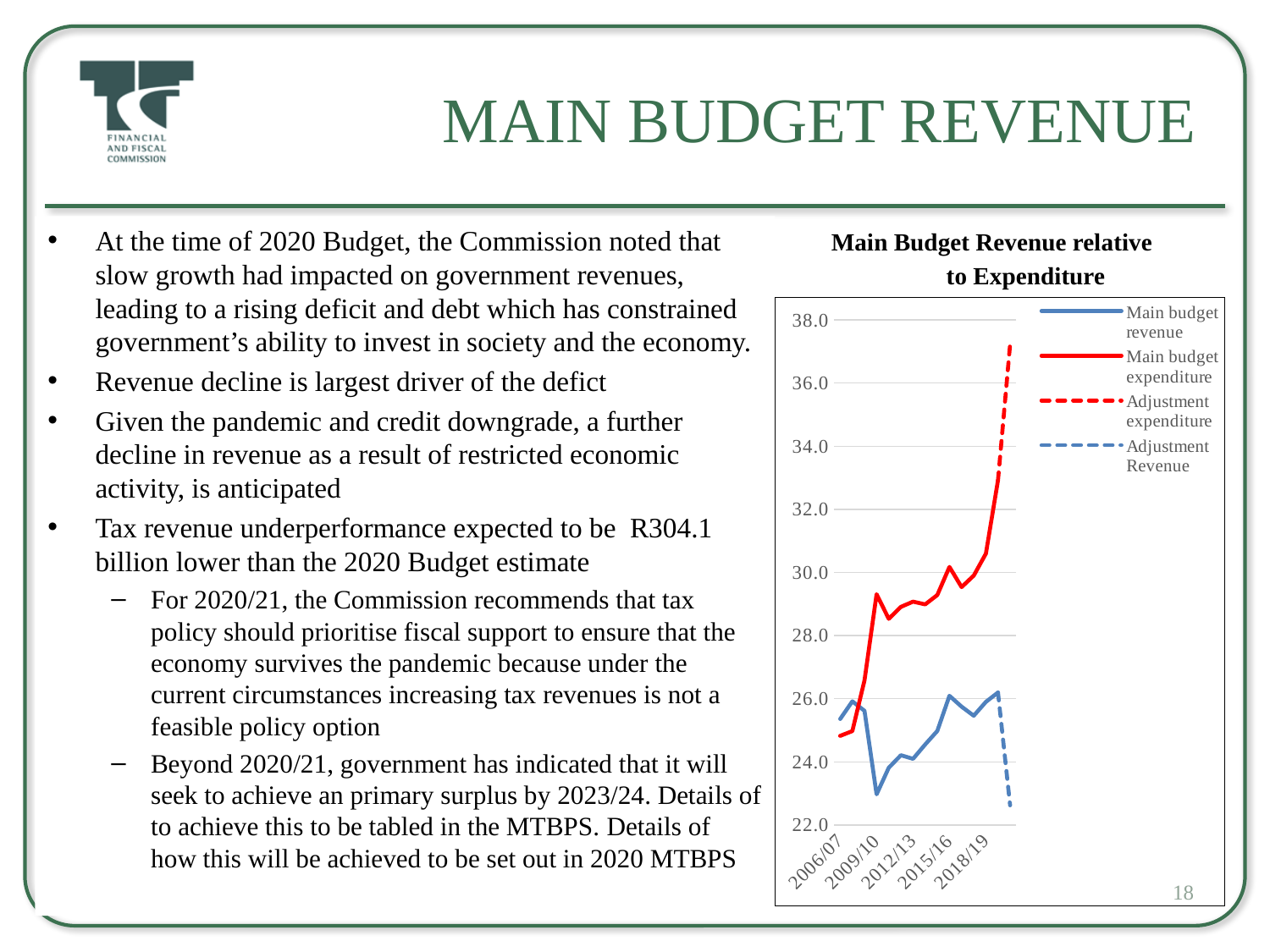
Is the value for Main budget revenue at 2009/10 greater or less than 24.0? less What is the title of the chart? Main Budget Revenue relative to Expenditure Is the value for Main budget expenditure at 2015/16 greater or less than 28.0? greater Is the value for Main budget expenditure at 2006/07 greater or less than 26.0? less How many series does the chart legend list? 4 Which series is drawn as a solid red line? Main budget expenditure What kind of chart is shown on the slide? line chart Does the Main budget expenditure line generally rise or fall from 2006/07 to 2018/19? rise At 2012/13, which is larger: Main budget expenditure or Main budget revenue? Main budget expenditure